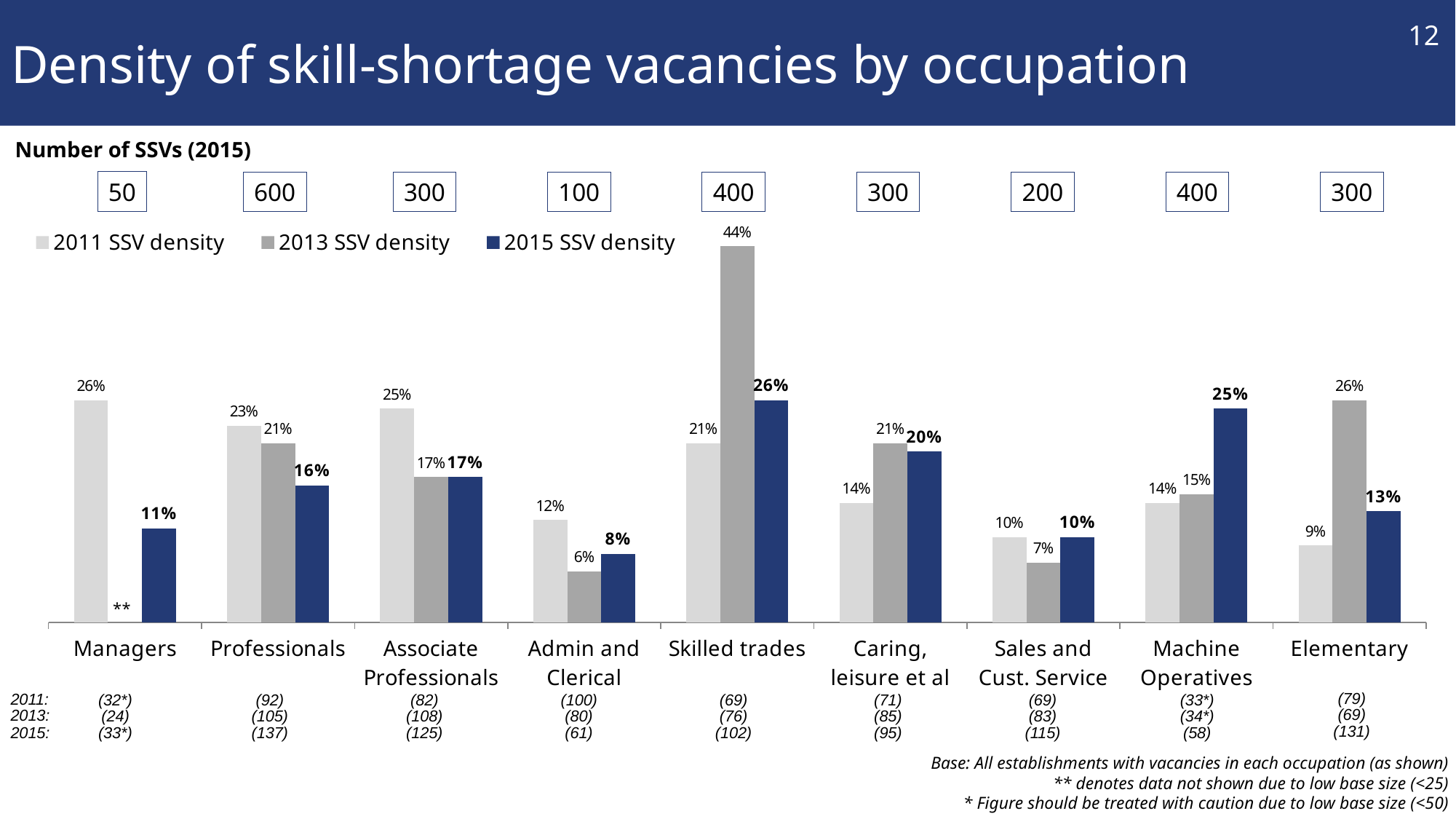
What is the 2013 SSV density for Admin and Clerical? 6% Which series is shown in dark blue in the legend? 2015 SSV density What is the 2015 SSV density for Skilled trades? 26% Did the SSV density for Professionals rise or fall from 2011 to 2015? Fall What is the 2011 SSV density for Managers? 26% How many occupation categories are shown on the x axis? 9 How many series does the legend list? 3 Which occupation has the highest 2013 SSV density? Skilled trades What kind of chart is shown on the slide? Bar chart Which is larger for Machine Operatives: the 2011 SSV density or the 2015 SSV density? 2015 SSV density Which occupation has the lowest 2015 SSV density? Admin and Clerical What is the difference between the 2013 and 2015 SSV density for Elementary? 13%